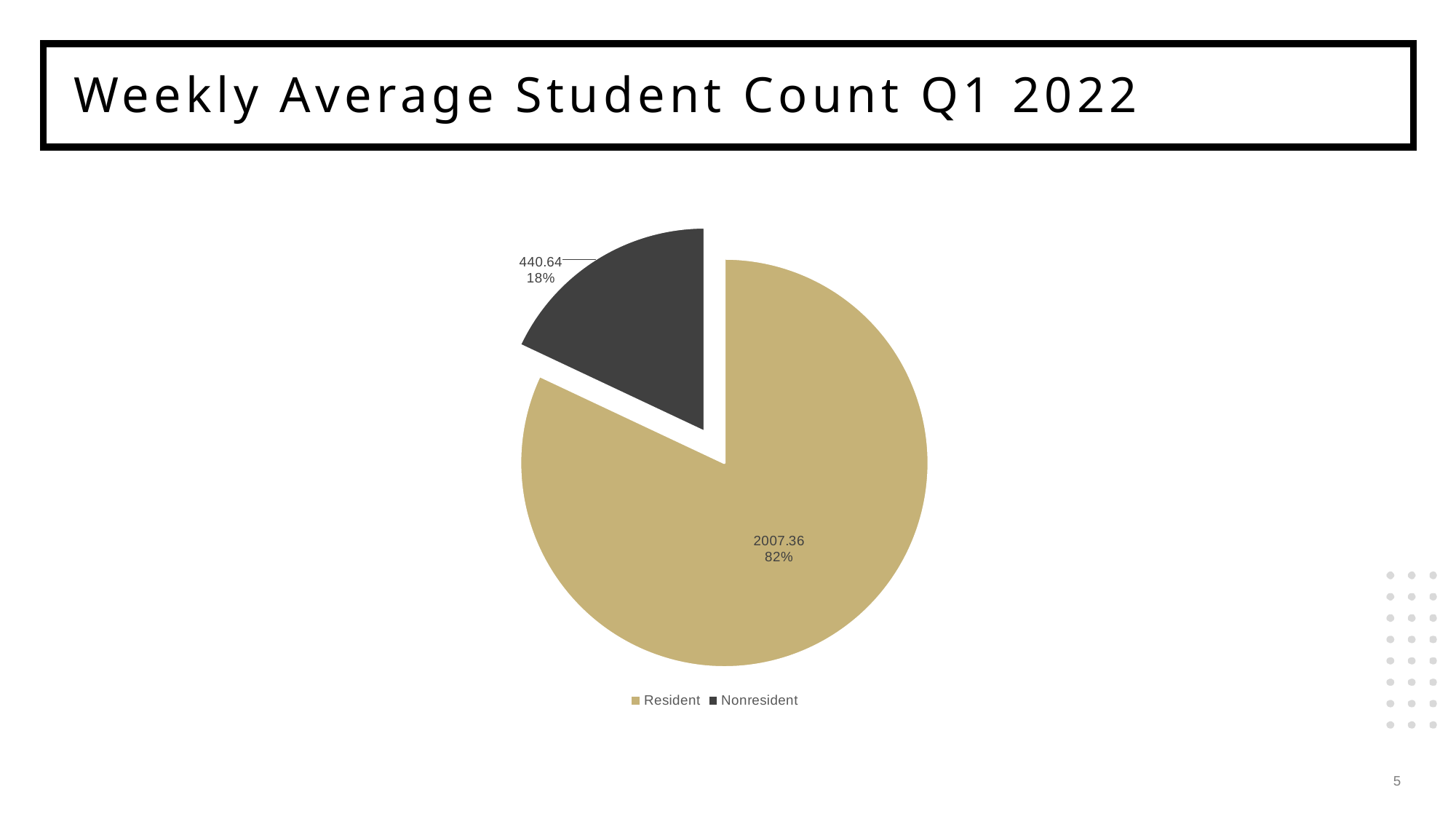
What is the weekly average student count for Resident? 2007.36 Which category is shown in the dark grey slice? Nonresident What kind of chart is shown on the slide? Pie chart What is the difference between the Resident and Nonresident values? 1566.72 Which category has the smallest slice of the pie? Nonresident What is the title of the slide? Weekly Average Student Count Q1 2022 What share of the pie does the Resident slice represent? 82% What is the weekly average student count for Nonresident? 440.64 What share of the pie does the Nonresident slice represent? 18% Which is larger, the Resident value or the Nonresident value? Resident How many categories are shown in the pie chart? 2 Which category has the largest slice of the pie? Resident